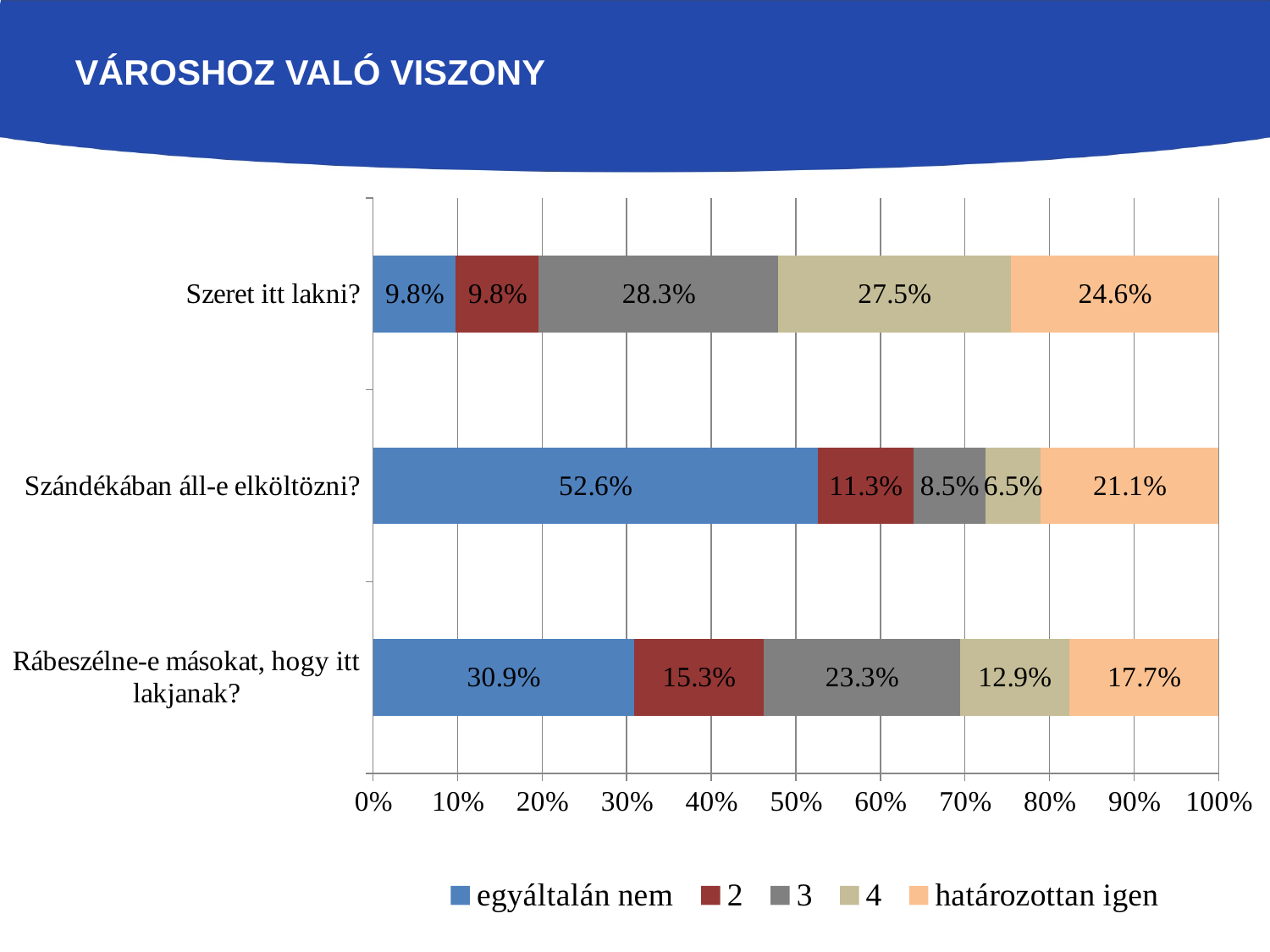
What is the value of 'egyáltalán nem' for 'Szándékában áll-e elköltözni?'? 52.6% What is the value of series '3' for 'Rábeszélne-e másokat, hogy itt lakjanak?'? 23.3% How many series does the legend list? 5 What is the value of series '4' for 'Szándékában áll-e elköltözni?'? 6.5% Which category has the highest 'egyáltalán nem' value? Szándékában áll-e elköltözni? What is the value of 'határozottan igen' for 'Szeret itt lakni?'? 24.6% Which category has the lowest 'határozottan igen' value? Rábeszélne-e másokat, hogy itt lakjanak? Which legend entry is shown in the lightest orange colour? határozottan igen How many categories (questions) are plotted on the chart? 3 Which is larger: series '4' for 'Szeret itt lakni?' or series '4' for 'Rábeszélne-e másokat, hogy itt lakjanak?'? Szeret itt lakni? What kind of chart is shown on the slide? stacked bar chart What is the difference between the 'egyáltalán nem' values for 'Szándékában áll-e elköltözni?' and 'Rábeszélne-e másokat, hogy itt lakjanak?'? 21.7 percentage points